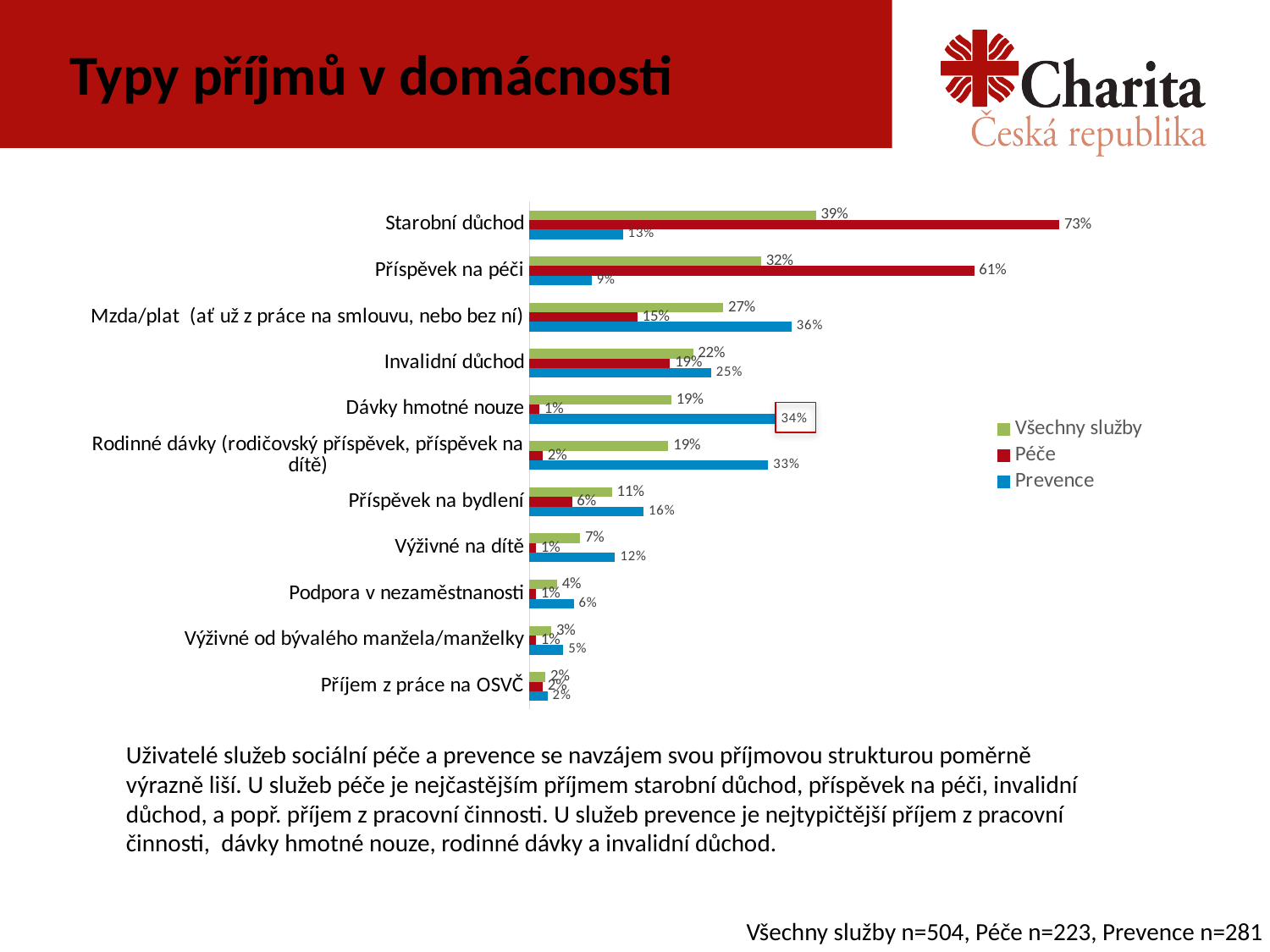
Which category has the highest value for the Prevence series? Mzda/plat (ať už z práce na smlouvu, nebo bez ní) What is the difference between the Všechny služby and Péče values for Invalidní důchod? 3% What type of chart is shown on the slide? bar chart Which series is shown in red in the legend? Péče How many series does the legend list? 3 For Dávky hmotné nouze, which is larger: the Péče value or the Prevence value? Prevence Which category has the lowest value for the Všechny služby series? Příjem z práce na OSVČ How many income categories are shown on the chart? 11 What is the value for Péče in the Starobní důchod category? 73% What is the value for Všechny služby in the Příspěvek na bydlení category? 11% What is the value for Prevence in the Mzda/plat category? 36% What is the difference between the Péče and Prevence values for Příspěvek na péči? 52%